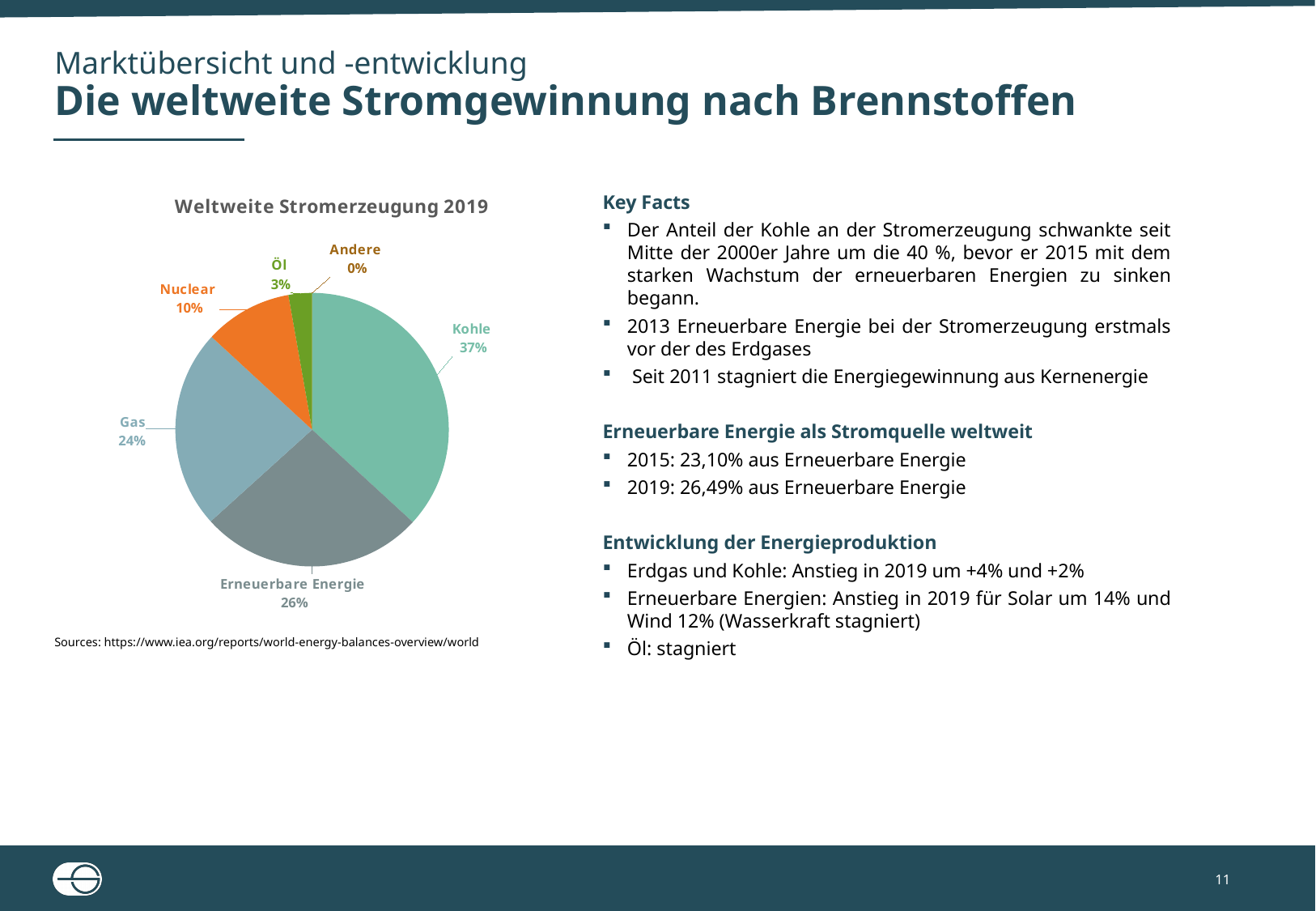
What kind of chart is shown on the slide? pie chart What share of the pie does Erneuerbare Energie have? 26% Which category has the largest share of the pie? Kohle What share of the pie does Gas have? 24% What is the title of the chart? Weltweite Stromerzeugung 2019 What share of the pie does Nuclear have? 10% What share of the pie does Öl have? 3% Which labelled category has the smallest share of the pie? Andere What is the difference between the shares of Kohle and Gas? 13% What share of the pie does Kohle have? 37% How many categories are shown in the pie chart? 6 Which is larger, the share of Erneuerbare Energie or the share of Gas? Erneuerbare Energie